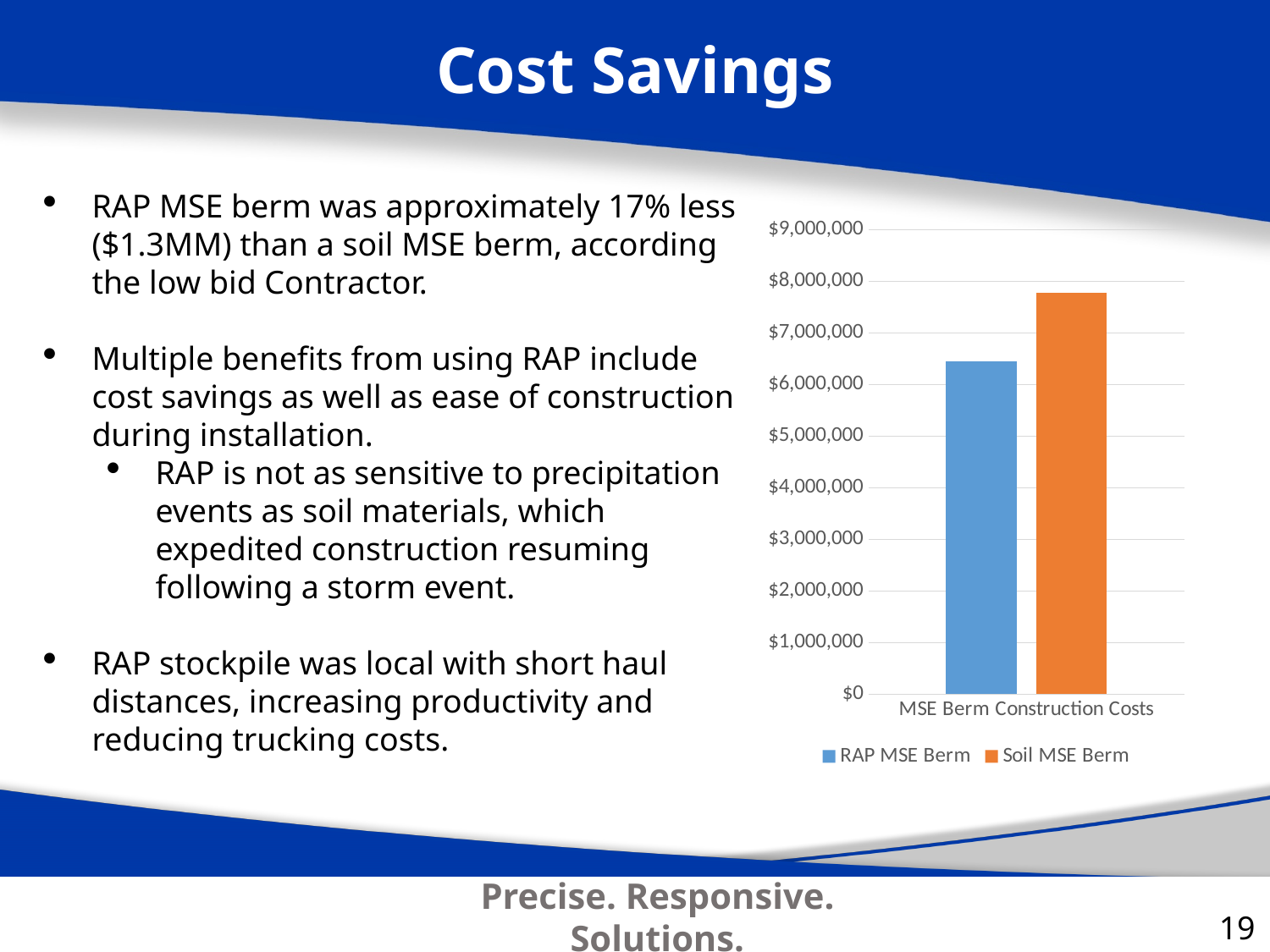
How many series does the chart legend list? 2 Which series shows the lowest construction cost in the chart? RAP MSE Berm What is the category label shown on the x axis of the chart? MSE Berm Construction Costs Which series has the higher value for MSE Berm Construction Costs, RAP MSE Berm or Soil MSE Berm? Soil MSE Berm Is the value for Soil MSE Berm greater or less than $7,000,000? greater Is the value for Soil MSE Berm greater or less than $8,000,000? less What colour is the bar for Soil MSE Berm in the chart? orange Is the value for RAP MSE Berm greater or less than $6,000,000? greater Which series shows the highest construction cost in the chart? Soil MSE Berm How many categories are shown on the x axis of the chart? 1 What kind of chart is shown on the slide? bar chart